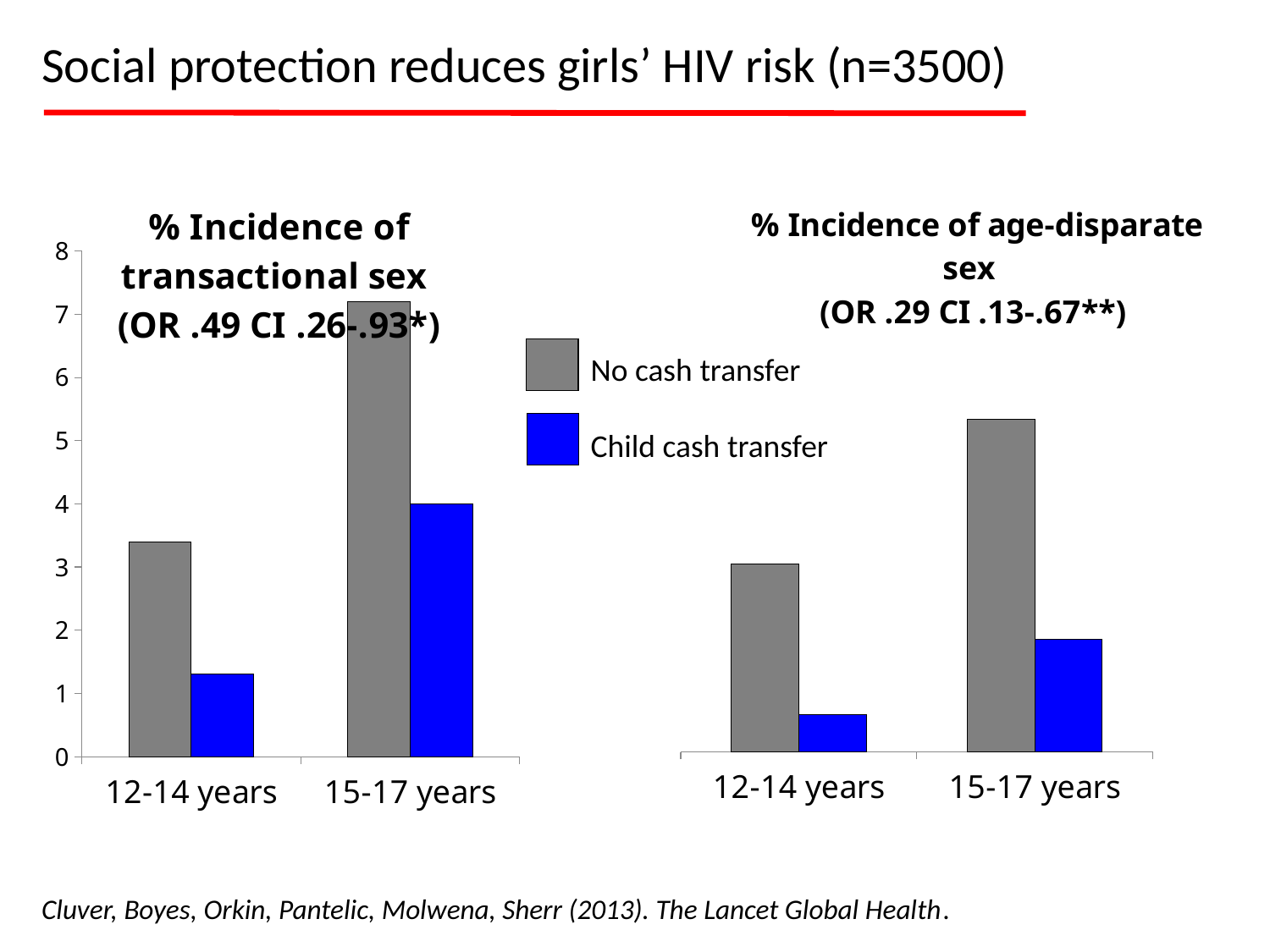
In the right chart, '% Incidence of age-disparate sex', which age group has the lowest 'Child cash transfer' value? 12-14 years In the left chart, '% Incidence of transactional sex', which bar is the lowest overall? Child cash transfer, 12-14 years In the right chart, '% Incidence of age-disparate sex', which is larger for 15-17 years: 'No cash transfer' or 'Child cash transfer'? No cash transfer In the left chart, '% Incidence of transactional sex', is the 'No cash transfer' value for 12-14 years greater or less than 3? greater In the left chart, '% Incidence of transactional sex', is the 'Child cash transfer' value for 12-14 years greater or less than 2? less How many series does the legend list? 2 What colour represents 'Child cash transfer' in the legend? blue In the right chart, '% Incidence of age-disparate sex', do the 'No cash transfer' values rise or fall from 12-14 years to 15-17 years? rise What kind of chart is the left chart, '% Incidence of transactional sex'? bar chart In the left chart, '% Incidence of transactional sex', how many age categories are shown on the x axis? 2 In the left chart, '% Incidence of transactional sex', is the 'No cash transfer' value for 15-17 years greater or less than 7? greater In the left chart, '% Incidence of transactional sex', which age group has the highest 'No cash transfer' value? 15-17 years